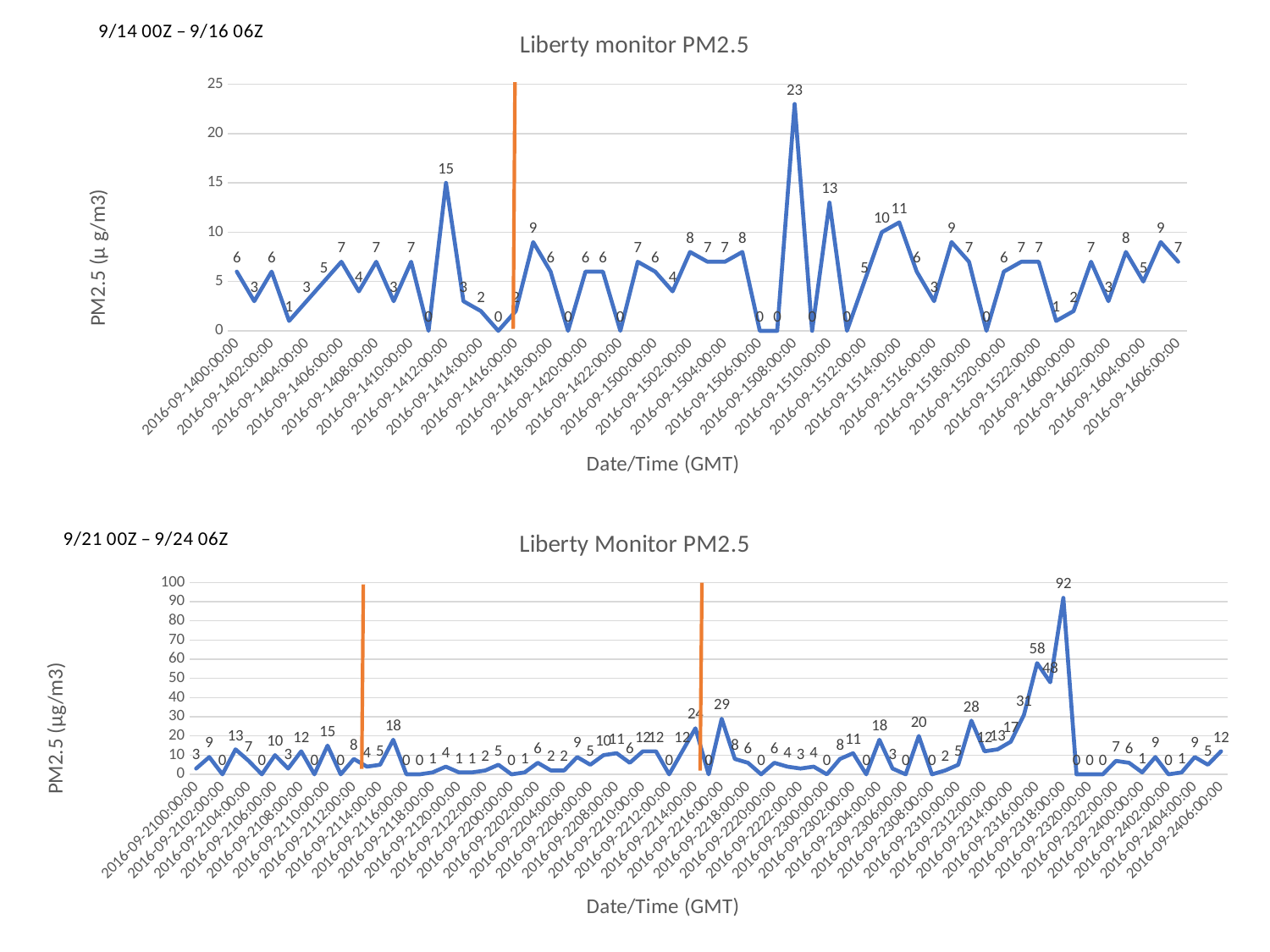
In the top chart (9/14 00Z – 9/16 06Z), what is the maximum value shown on the y axis? 25 In the bottom chart (9/21 00Z – 9/24 06Z), what is the PM2.5 value at 2016-09-23 16:00:00? 58 In the bottom chart (9/21 00Z – 9/24 06Z), at which date/time does the peak value of 92 occur? 2016-09-2318:00:00 In the bottom chart (9/21 00Z – 9/24 06Z), is the peak value of 92 greater or less than 90 on the y axis? greater Which chart has the higher peak PM2.5 value, the top chart or the bottom chart? the bottom chart What type of chart is the top chart titled 'Liberty monitor PM2.5'? line chart In the top chart (9/14 00Z – 9/16 06Z), at which date/time does the peak value of 23 occur? 2016-09-1508:00:00 In the top chart (9/14 00Z – 9/16 06Z), what is the highest PM2.5 value plotted? 23 In the top chart (9/14 00Z – 9/16 06Z), what is the difference between the peak value of 23 and the next peak of 13? 10 In the top chart (9/14 00Z – 9/16 06Z), what is the PM2.5 value at 2016-09-14 12:00:00? 15